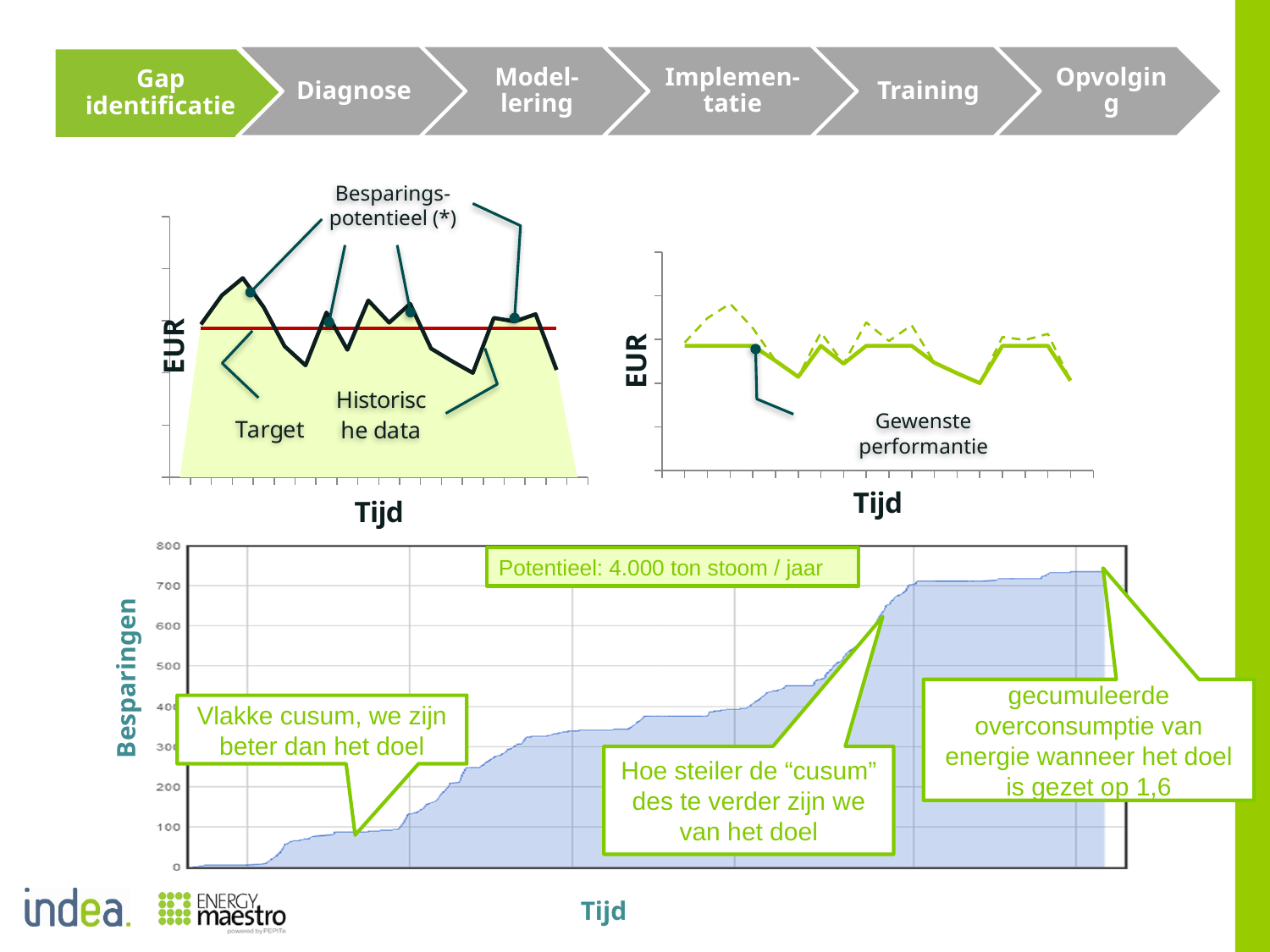
What kind of chart is the top-left chart with the EUR axis? area chart In the top-left chart, what does the red horizontal line represent? Target In the bottom chart, is the final value at the right end greater or less than 700? greater What potential (Potentieel) is stated in the box on the bottom chart? 4.000 ton stoom / jaar In the bottom chart, is the value at the far left start greater or less than 100? less What kind of chart is the bottom chart labelled 'Besparingen'? area chart What is the y-axis label of the bottom chart? Besparingen In the bottom chart, do the values rise or fall along the x axis (Tijd)? rise How many tick values are labelled on the y axis of the bottom chart (from 0 to 800)? 9 What is the highest tick value shown on the y axis of the bottom chart? 800